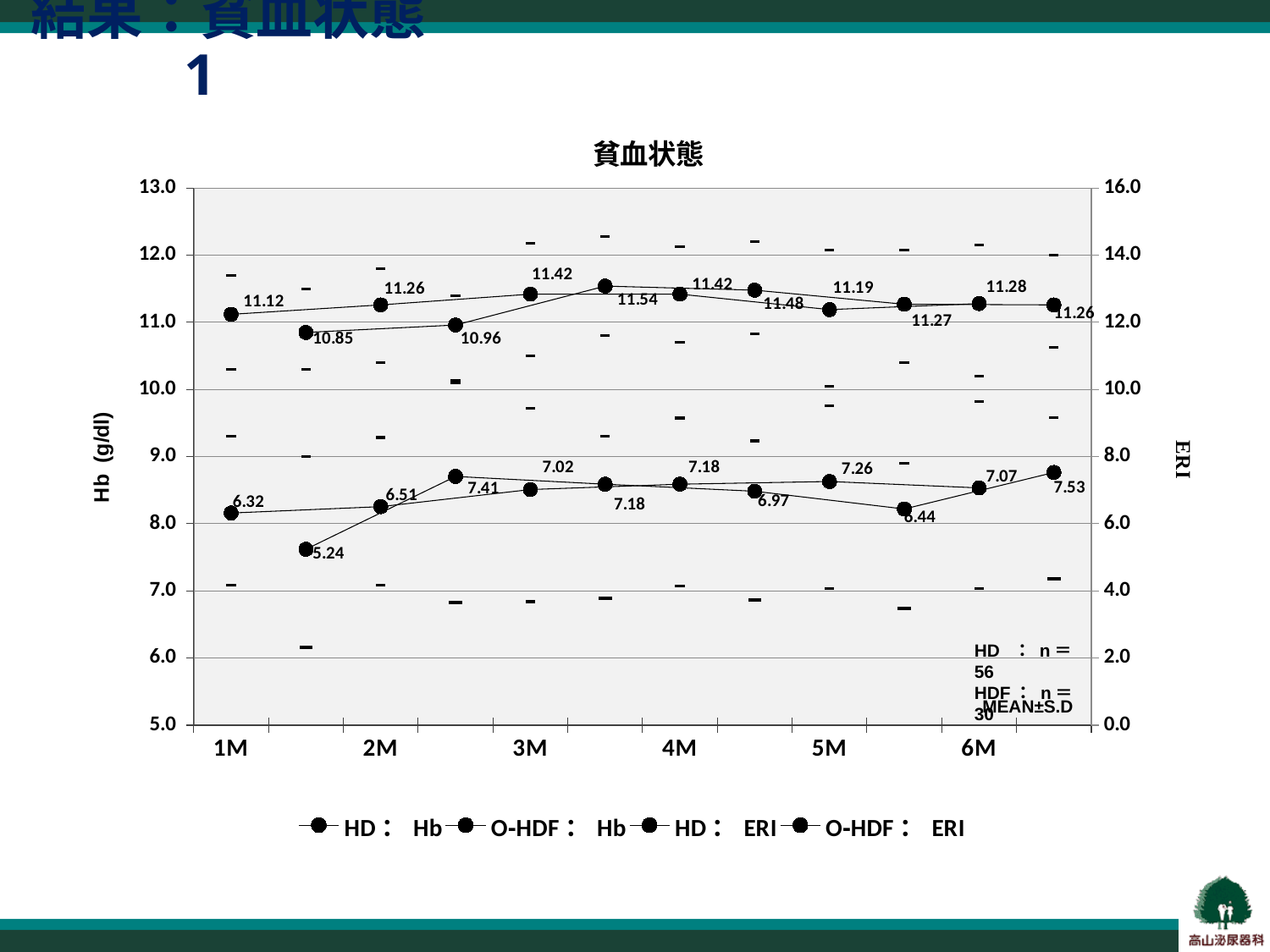
What type of chart is shown on the slide? line chart What is the title of the chart? 貧血状態 What is the lowest Hb value labeled on the chart? 10.85 What is the ERI value labeled at 1M? 6.32 What is the label of the left vertical axis? Hb (g/dl) What is the highest ERI value labeled on the chart? 7.53 How many series does the legend list? 4 What is the difference between the highest labeled Hb value (11.54) and the lowest labeled Hb value (10.85)? 0.69 What is the lowest ERI value labeled on the chart? 5.24 What is the highest Hb value labeled on the chart? 11.54 How many month labels are shown on the x axis? 6 What is the Hb value labeled at 1M? 11.12